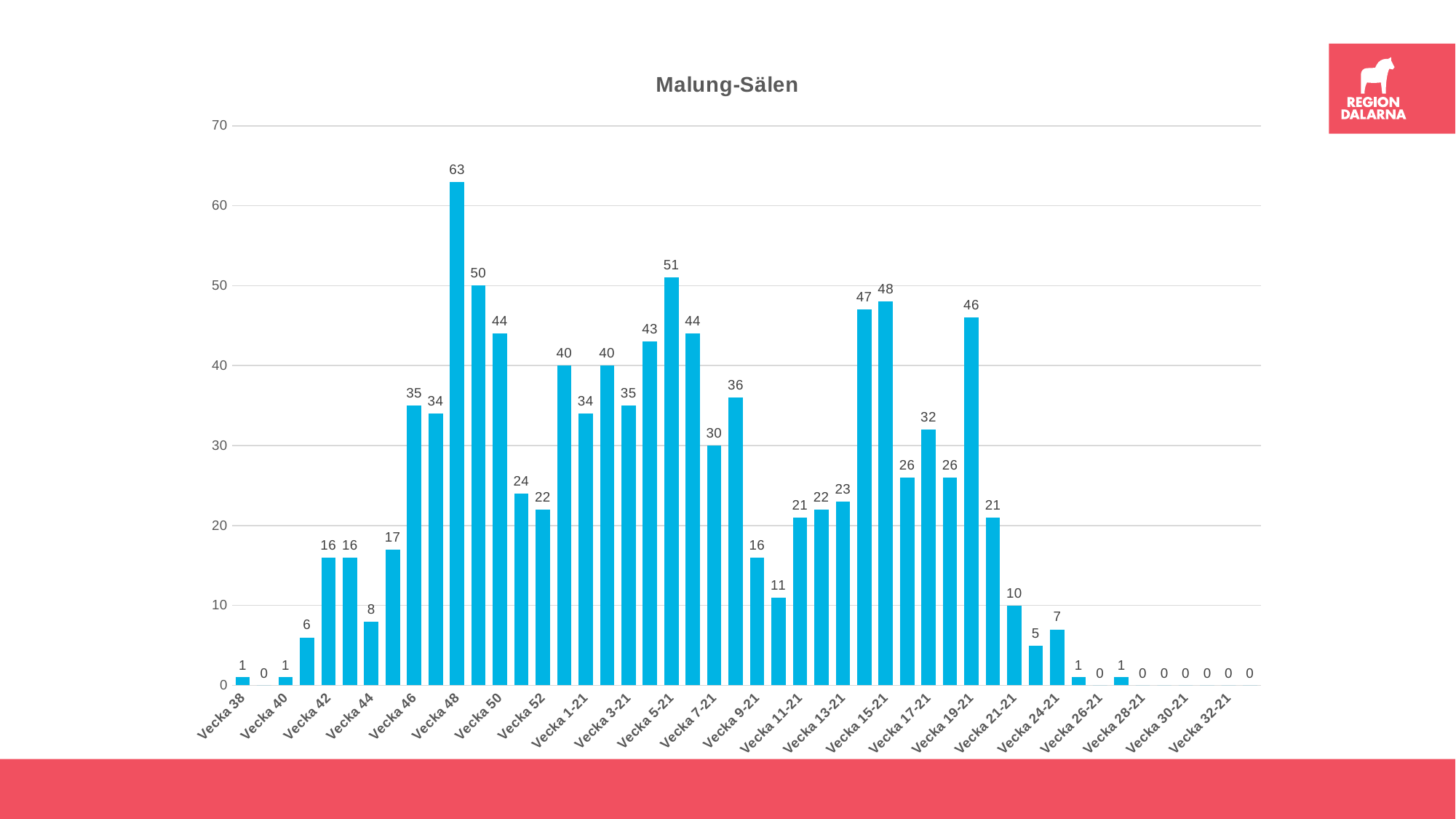
What is the value for Vecka 5-21? 51 What is the value for Vecka 32-21? 0 What is the title of the chart? Malung-Sälen What is the value for Vecka 15-21? 48 Which week has the highest value in the Malung-Sälen chart? Vecka 48 What kind of chart is shown on the slide? bar chart What is the value for Vecka 19-21? 46 Is the value for Vecka 9-21 greater or less than 20? less Do the values rise or fall from Vecka 19-21 to Vecka 26-21? fall What is the value for Vecka 48? 63 What is the difference between the values for Vecka 48 and Vecka 5-21? 12 Which is larger, the value for Vecka 50 or the value for Vecka 7-21? Vecka 50